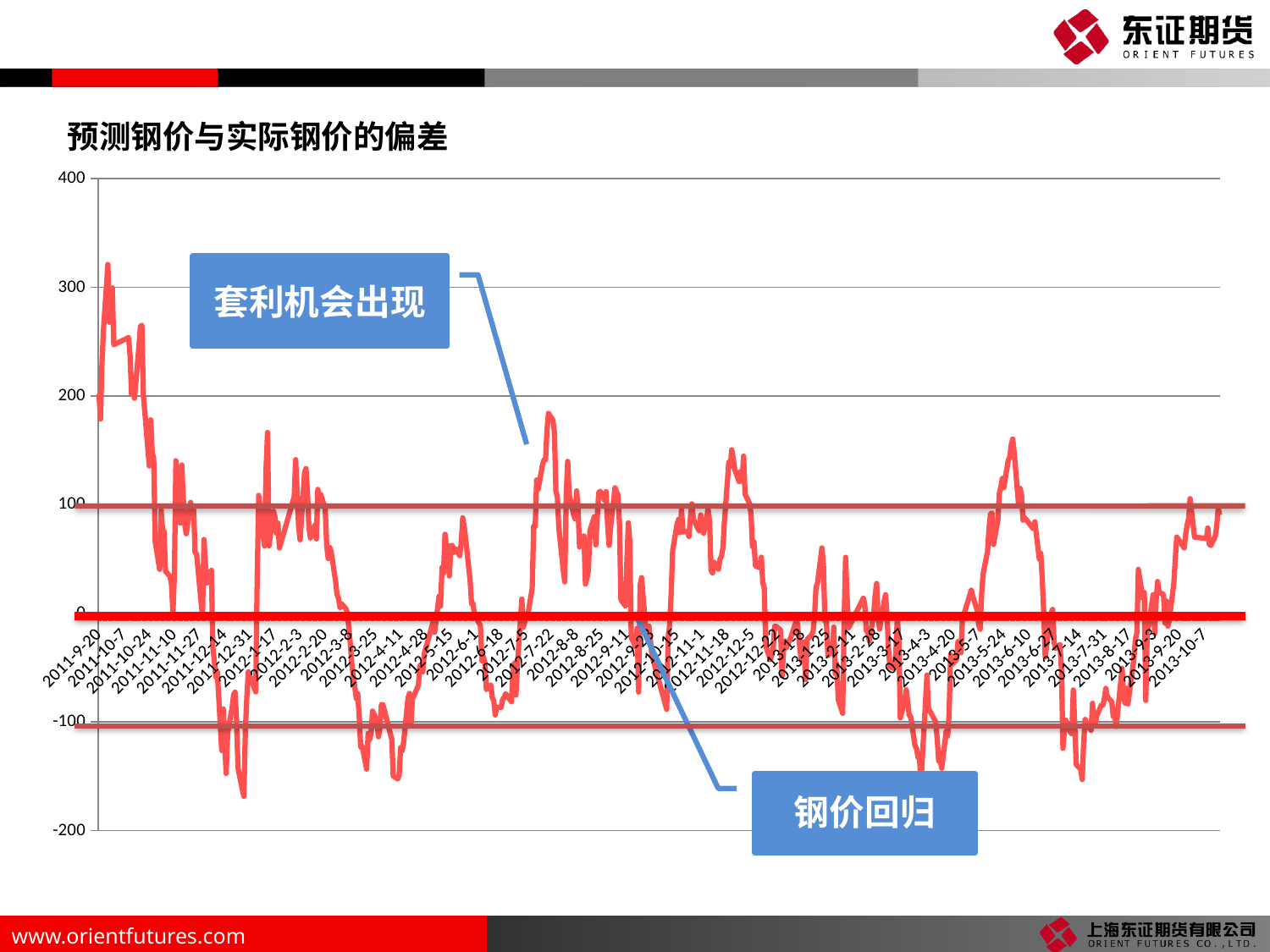
Is the value for 2012-7-22 greater or less than 100? greater What is the lowest value shown on the vertical axis? -200 Is the value for 2011-10-7 greater or less than 200? greater Is the value for 2013-10-7 greater or less than 0? greater What is the title of the chart? 预测钢价与实际钢价的偏差 Does the line start higher or lower than it ends? higher What kind of chart is shown on the slide? line chart What is the highest value shown on the vertical axis? 400 Is the highest point of the line near the beginning or the end of the date range? beginning